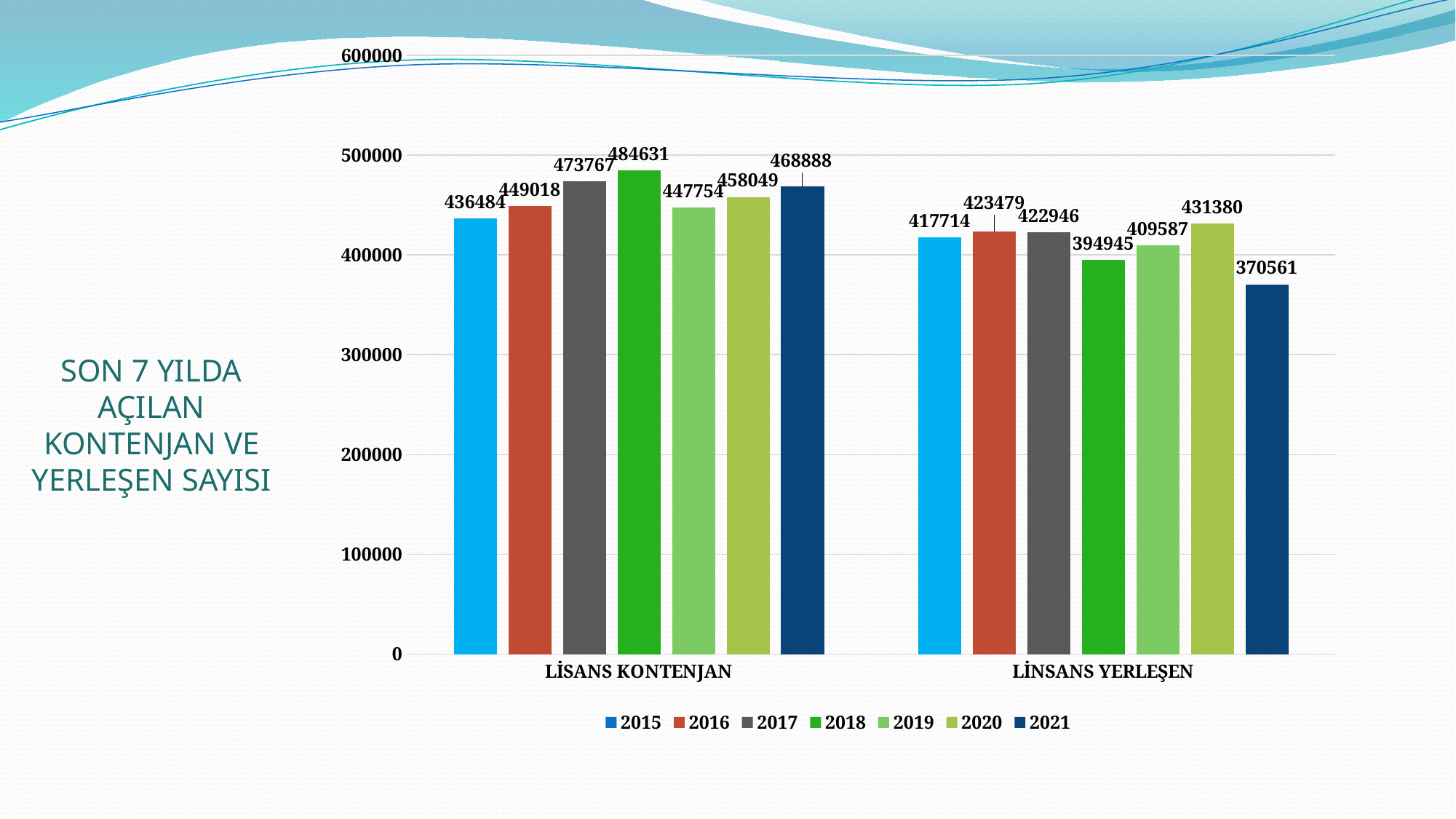
What is the difference between the 2020 values for LİSANS KONTENJAN and LİNSANS YERLEŞEN? 26669 What is the value for 2021 in the LİNSANS YERLEŞEN category? 370561 Which is larger: the 2019 value for LİSANS KONTENJAN or the 2019 value for LİNSANS YERLEŞEN? LİSANS KONTENJAN Which year has the highest value in the LİSANS KONTENJAN category? 2018 What is the value for 2018 in the LİSANS KONTENJAN category? 484631 Which year has the lowest value in the LİNSANS YERLEŞEN category? 2021 How many categories are shown on the x axis? 2 What kind of chart is shown on the slide? bar chart How many series does the legend list? 7 What is the difference between the 2018 and 2021 values in the LİSANS KONTENJAN category? 15743 Is the 2018 value for LİNSANS YERLEŞEN greater or less than 400000? less What is the value for 2015 in the LİSANS KONTENJAN category? 436484